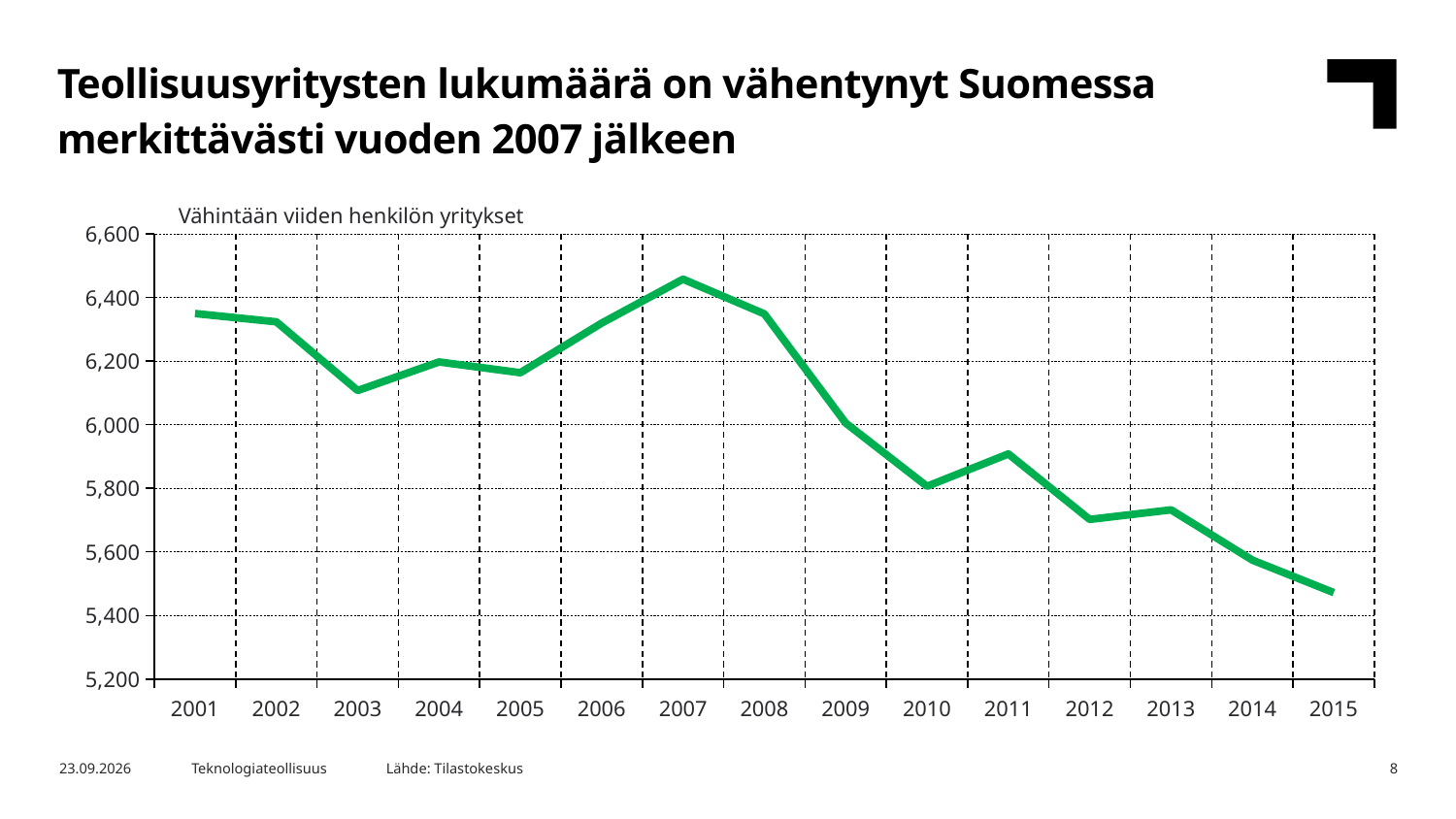
In which year is the number of companies lowest? 2015 Is the value for 2007 greater or less than 6,400? greater What is the title shown above the chart? Vähintään viiden henkilön yritykset How many years are plotted on the x axis of the chart? 15 Is the value for 2015 greater or less than 5,600? less Which year has a higher value, 2001 or 2015? 2001 Is the value for 2012 greater or less than 5,800? less In which year does the number of companies reach its highest point? 2007 Does the number of companies rise or fall between 2007 and 2015? Fall What kind of chart is shown on the slide? Line chart